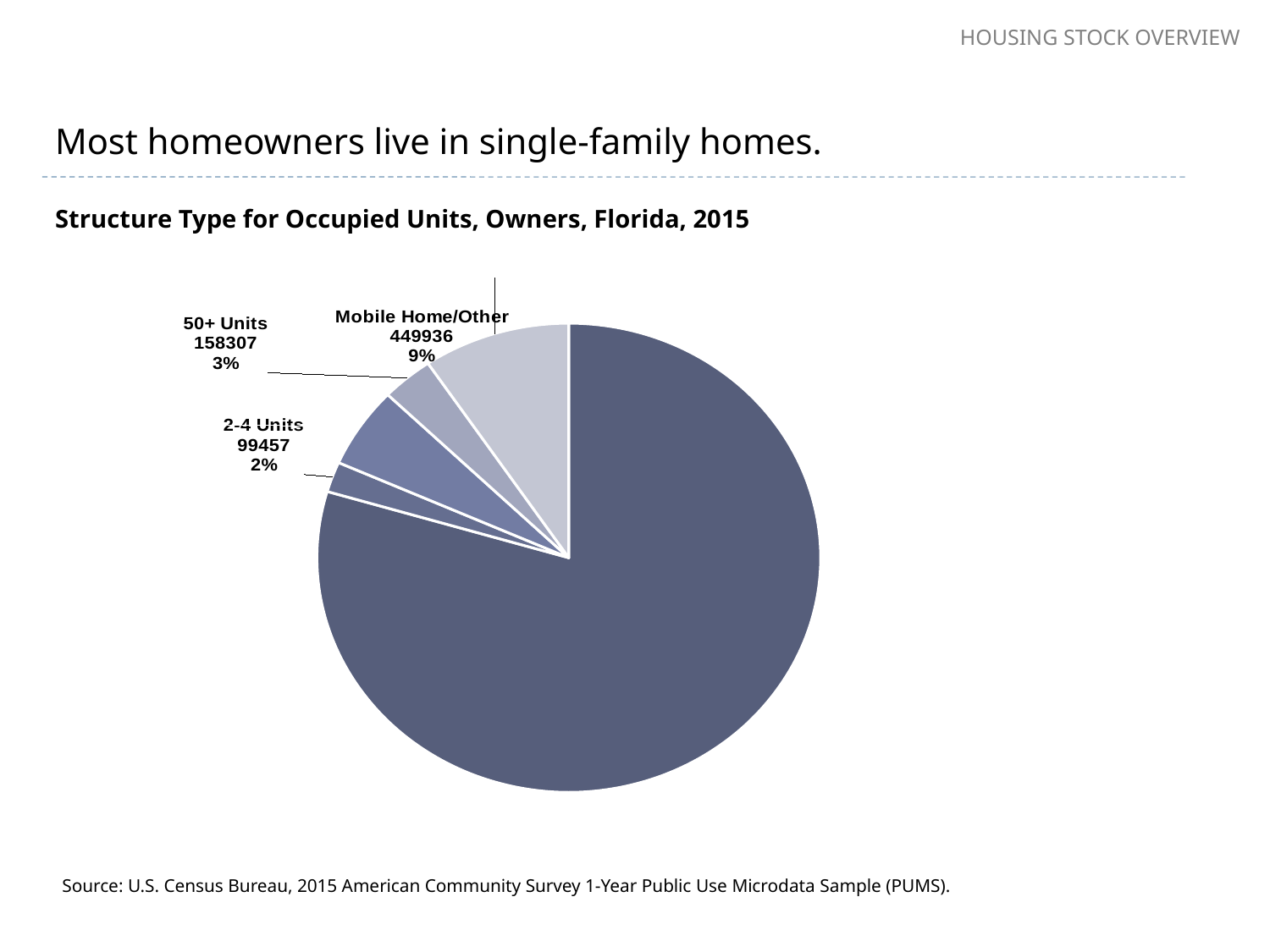
Which is larger, the value for 50+ Units or the value for 2-4 Units? 50+ Units Of the labeled categories, which has the largest value? Mobile Home/Other What is the value shown for 2-4 Units? 99457 What is the value shown for Mobile Home/Other? 449936 What share of the pie does 2-4 Units represent? 2% What is the value shown for 50+ Units? 158307 What share of the pie does 50+ Units represent? 3% What is the title of the chart? Structure Type for Occupied Units, Owners, Florida, 2015 What kind of chart is shown on the slide? pie chart What is the difference between the value for Mobile Home/Other and the value for 50+ Units? 291629 What share of the pie does Mobile Home/Other represent? 9% Of the labeled categories, which has the smallest value? 2-4 Units